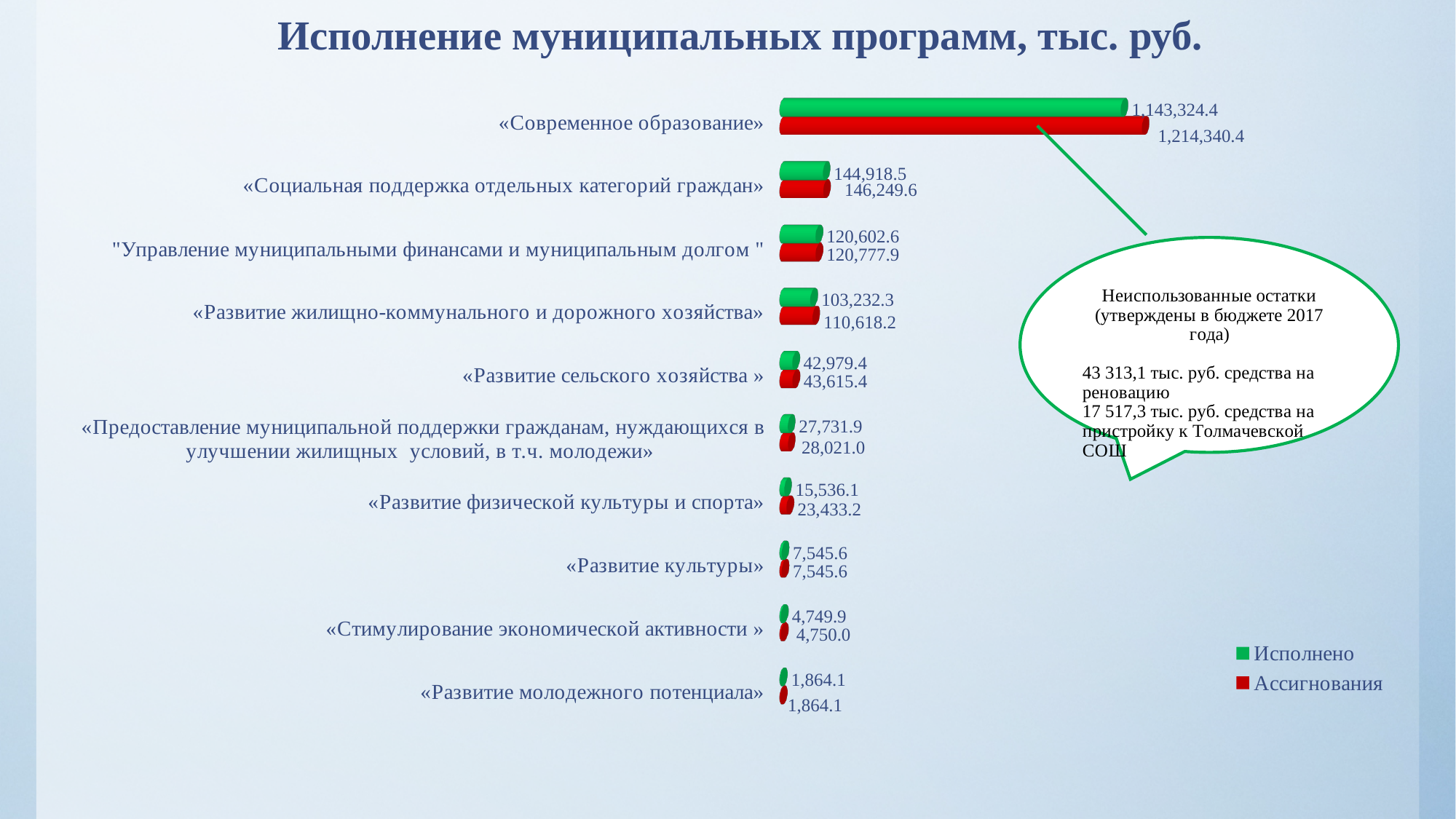
How many series does the legend list? 2 Which colour represents the Исполнено series in the chart? green How many programme categories are plotted in the chart? 10 What is the Исполнено value for «Развитие физической культуры и спорта»? 15,536.1 What is the Ассигнования value for «Развитие жилищно-коммунального и дорожного хозяйства»? 110,618.2 Which programme has the lowest Исполнено value? «Развитие молодежного потенциала» What is the Исполнено value for «Современное образование»? 1,143,324.4 What is the difference between Ассигнования and Исполнено for «Современное образование»? 71,016.0 What type of chart is shown on the slide? bar chart What is the Ассигнования value for «Стимулирование экономической активности »? 4,750.0 For «Развитие физической культуры и спорта», which is larger: Исполнено or Ассигнования? Ассигнования Which programme has the highest Ассигнования value? «Современное образование»